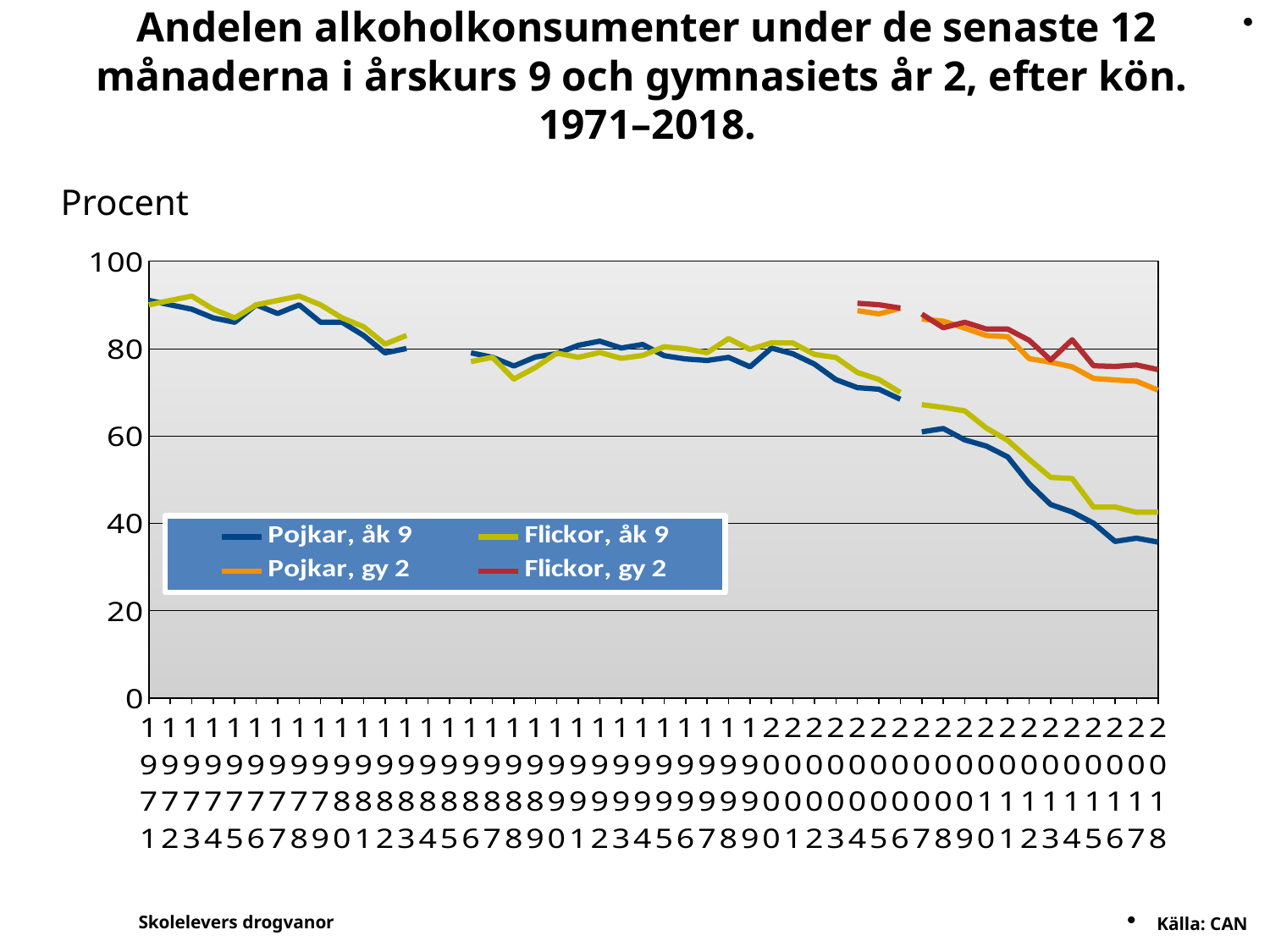
Is the value for Pojkar, åk 9 in 2018 greater or less than 40? less How many series does the legend list? 4 Which series is drawn in orange according to the legend? Pojkar, gy 2 Is the value for Flickor, åk 9 in 2018 greater or less than 40? greater Which series has the lowest value in 2018? Pojkar, åk 9 Is the value for Pojkar, åk 9 in 1971 greater or less than 80? greater In 2018, which is higher: Flickor, åk 9 or Pojkar, åk 9? Flickor, åk 9 Do the values for Pojkar, åk 9 rise or fall from 2000 to 2018? fall In 2018, which is higher: Flickor, gy 2 or Pojkar, gy 2? Flickor, gy 2 What is the label on the y axis of the chart? Procent What kind of chart is shown on the slide? line chart